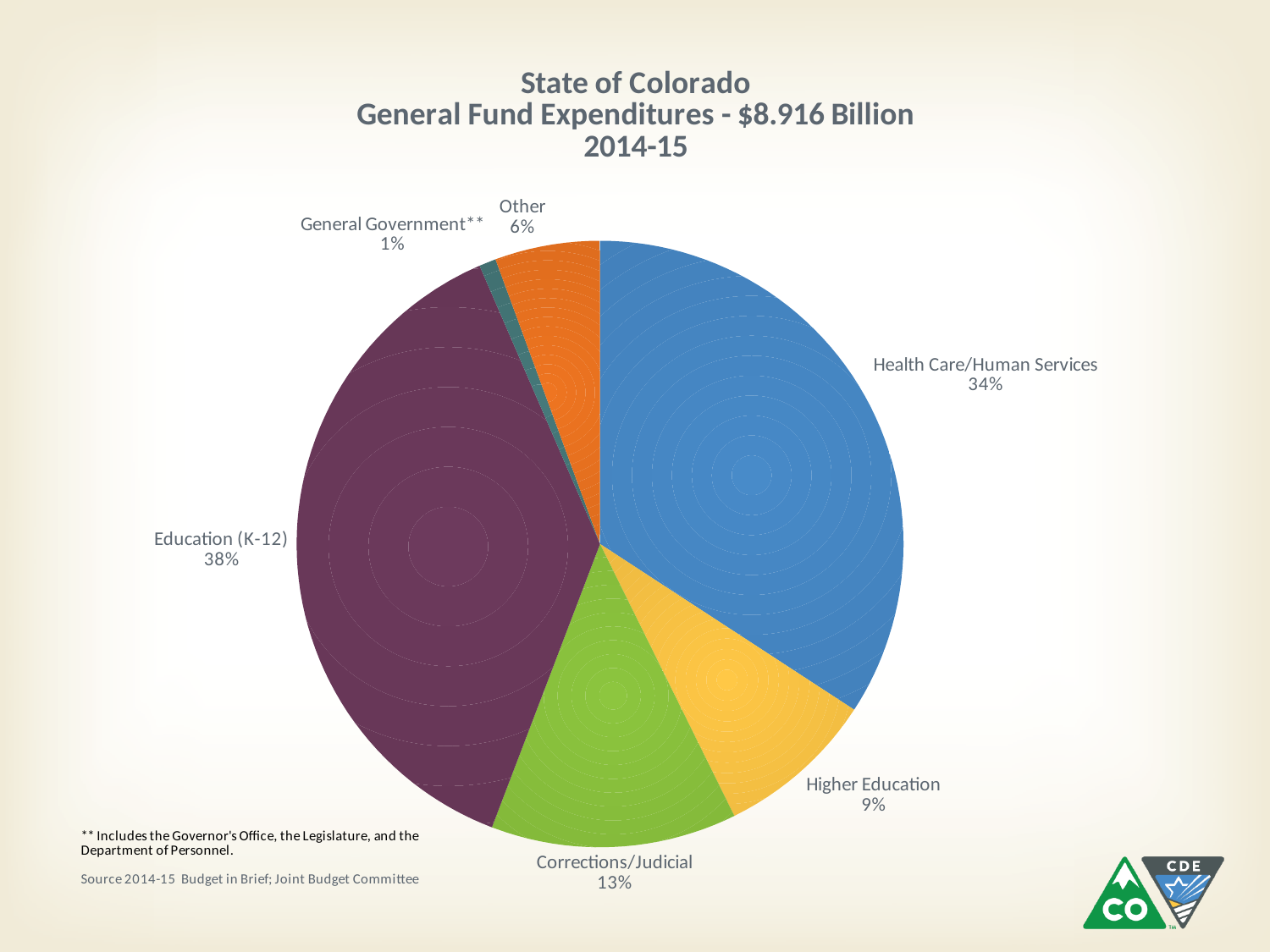
What percentage of the pie is Health Care/Human Services? 34% Which category has the smallest slice of the pie? General Government** How many slices does the pie chart have? 6 How many percentage points larger is Education (K-12) than Health Care/Human Services? 4 What kind of chart is shown on the slide? Pie chart Which is larger, Corrections/Judicial or Higher Education? Corrections/Judicial Which category has the largest slice of the pie? Education (K-12) What share of the pie is General Government**? 1% What percentage is labelled for Higher Education? 9% What share of General Fund expenditures goes to Education (K-12)? 38% What share is shown for Corrections/Judicial? 13% What total dollar amount of General Fund expenditures does the chart title give? $8.916 Billion